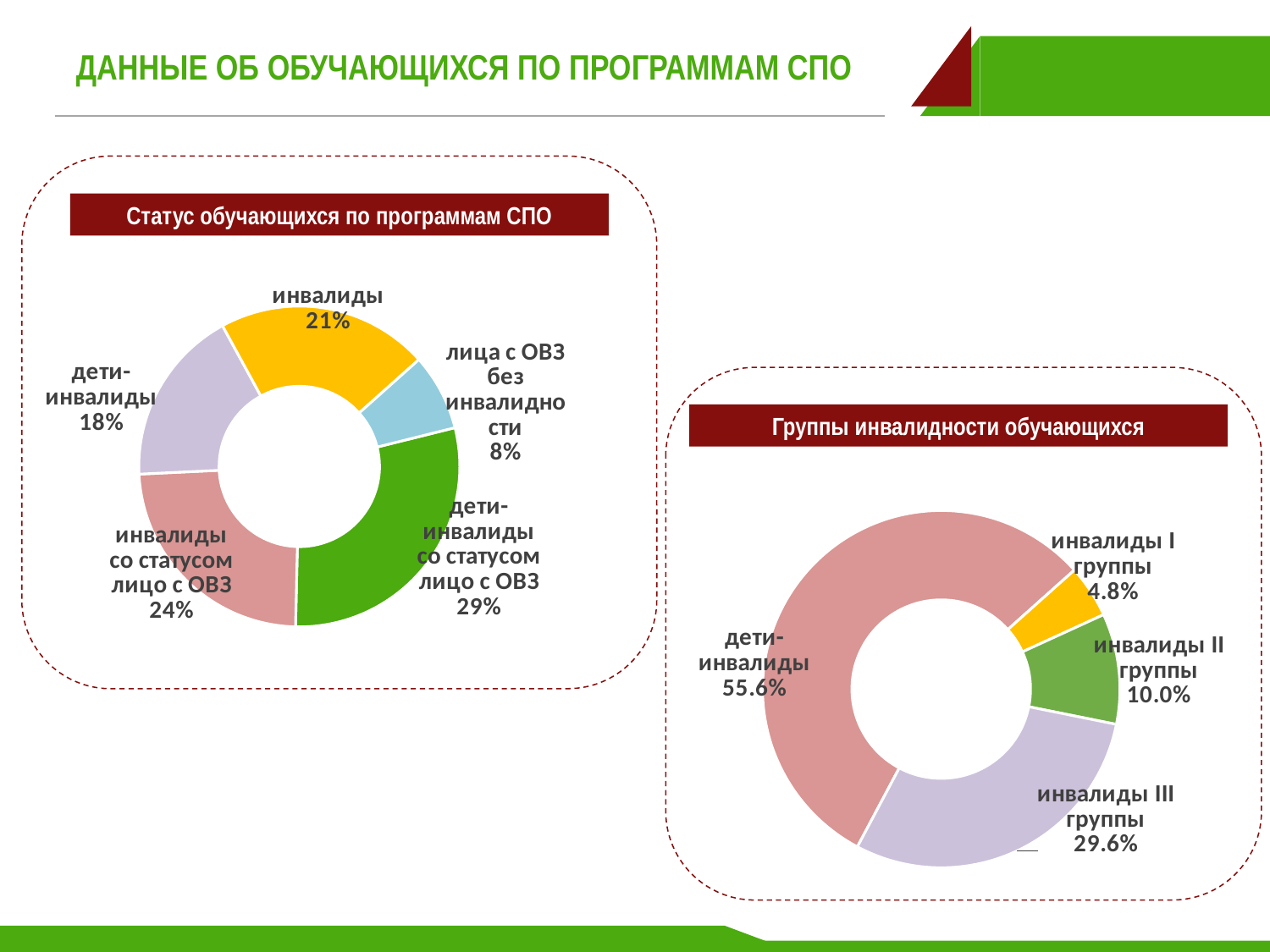
In the chart 'Статус обучающихся по программам СПО', which category has the smallest share? лица с ОВЗ без инвалидности In the chart 'Группы инвалидности обучающихся', which is larger: 'инвалиды II группы' or 'инвалиды III группы'? инвалиды III группы In the chart 'Статус обучающихся по программам СПО', what share is labelled for 'инвалиды'? 21% In the chart 'Группы инвалидности обучающихся', which category has the smallest share? инвалиды I группы In the chart 'Статус обучающихся по программам СПО', which category has the largest share? дети-инвалиды со статусом лицо с ОВЗ In the chart 'Статус обучающихся по программам СПО', how many categories are shown? 5 In the chart 'Статус обучающихся по программам СПО', what share is labelled for 'лица с ОВЗ без инвалидности'? 8% In the chart 'Статус обучающихся по программам СПО', what is the difference in percentage points between 'инвалиды со статусом лицо с ОВЗ' and 'дети-инвалиды'? 6 In the chart 'Группы инвалидности обучающихся', what share is labelled for 'дети-инвалиды'? 55.6% What type of chart is 'Группы инвалидности обучающихся'? doughnut (pie) chart In the chart 'Группы инвалидности обучающихся', how many categories are shown? 4 In the chart 'Группы инвалидности обучающихся', what share is labelled for 'инвалиды III группы'? 29.6%